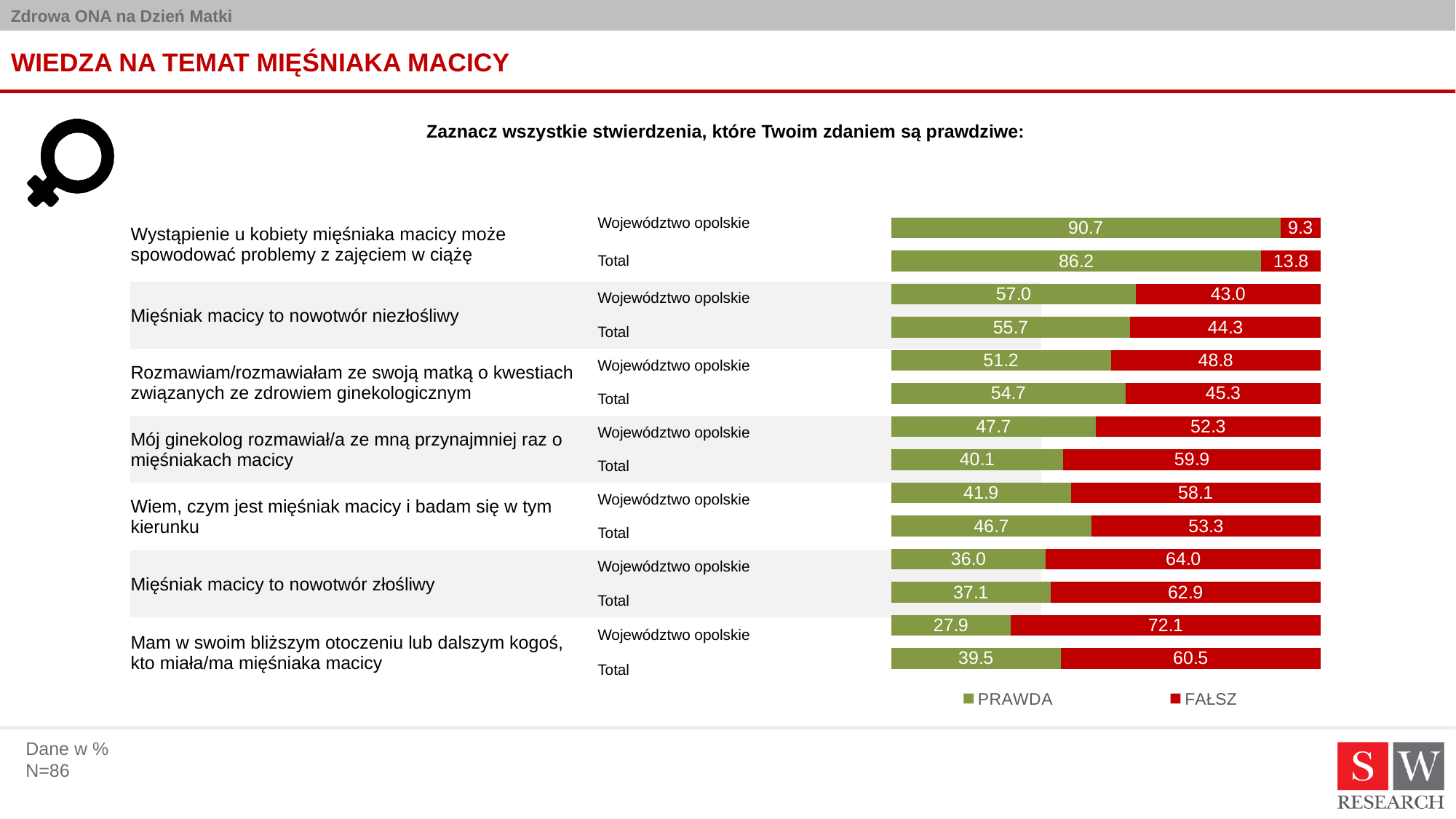
What is the PRAWDA value for Total for the statement "Mam w swoim bliższym otoczeniu lub dalszym kogoś, kto miała/ma mięśniaka macicy"? 39.5 How many series does the legend list? 2 For the statement "Mięśniak macicy to nowotwór złośliwy", which is larger: the FAŁSZ value for Województwo opolskie or for Total? Województwo opolskie Which bar has the lowest PRAWDA value? Województwo opolskie, "Mam w swoim bliższym otoczeniu lub dalszym kogoś, kto miała/ma mięśniaka macicy" How many bars are plotted in the chart? 14 Which bar has the highest PRAWDA value? Województwo opolskie, "Wystąpienie u kobiety mięśniaka macicy może spowodować problemy z zajęciem w ciążę" What is the total of the Total bar for the statement "Wiem, czym jest mięśniak macicy i badam się w tym kierunku"? 100.0 What is the FAŁSZ value for Total for the statement "Mięśniak macicy to nowotwór niezłośliwy"? 44.3 What is the PRAWDA value for Województwo opolskie for the statement "Wystąpienie u kobiety mięśniaka macicy może spowodować problemy z zajęciem w ciążę"? 90.7 Which colour represents the FAŁSZ series in the chart? Red What is the difference between the PRAWDA values for Województwo opolskie and Total for the statement "Mój ginekolog rozmawiał/a ze mną przynajmniej raz o mięśniakach macicy"? 7.6 What kind of chart is shown on the slide? Stacked bar chart